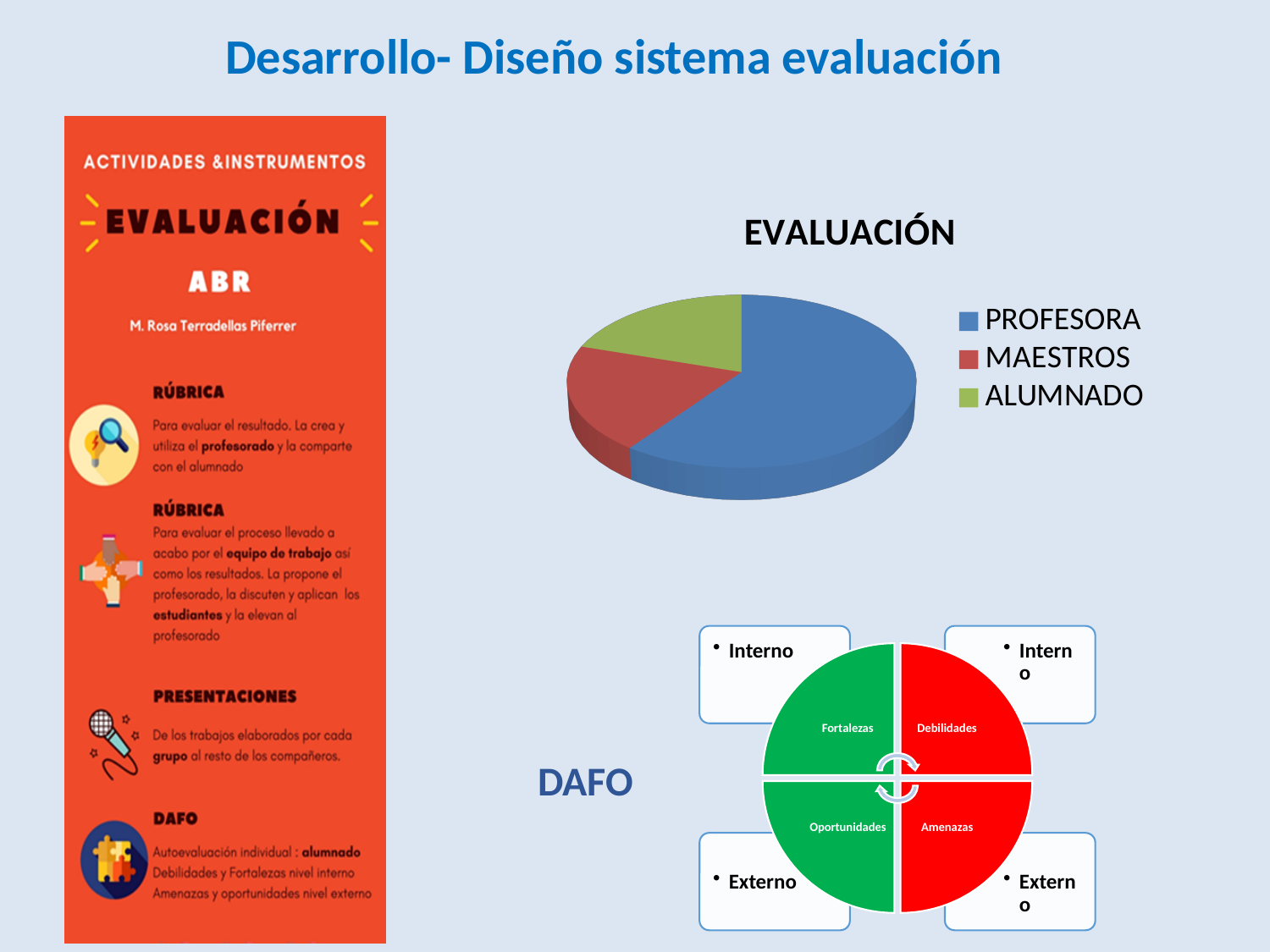
What is the title of the pie chart on the slide? EVALUACIÓN Is the PROFESORA slice of the EVALUACIÓN pie chart greater or less than half of the pie? greater How many slices does the EVALUACIÓN pie chart have? 3 How many entries does the legend of the EVALUACIÓN pie chart list? 3 Which colour represents ALUMNADO in the EVALUACIÓN pie chart? green In the EVALUACIÓN pie chart, which slice is larger, PROFESORA or MAESTROS? PROFESORA In the EVALUACIÓN pie chart, which slice is larger, PROFESORA or ALUMNADO? PROFESORA What kind of chart is the EVALUACIÓN chart? pie chart Which category has the largest slice in the EVALUACIÓN pie chart? PROFESORA